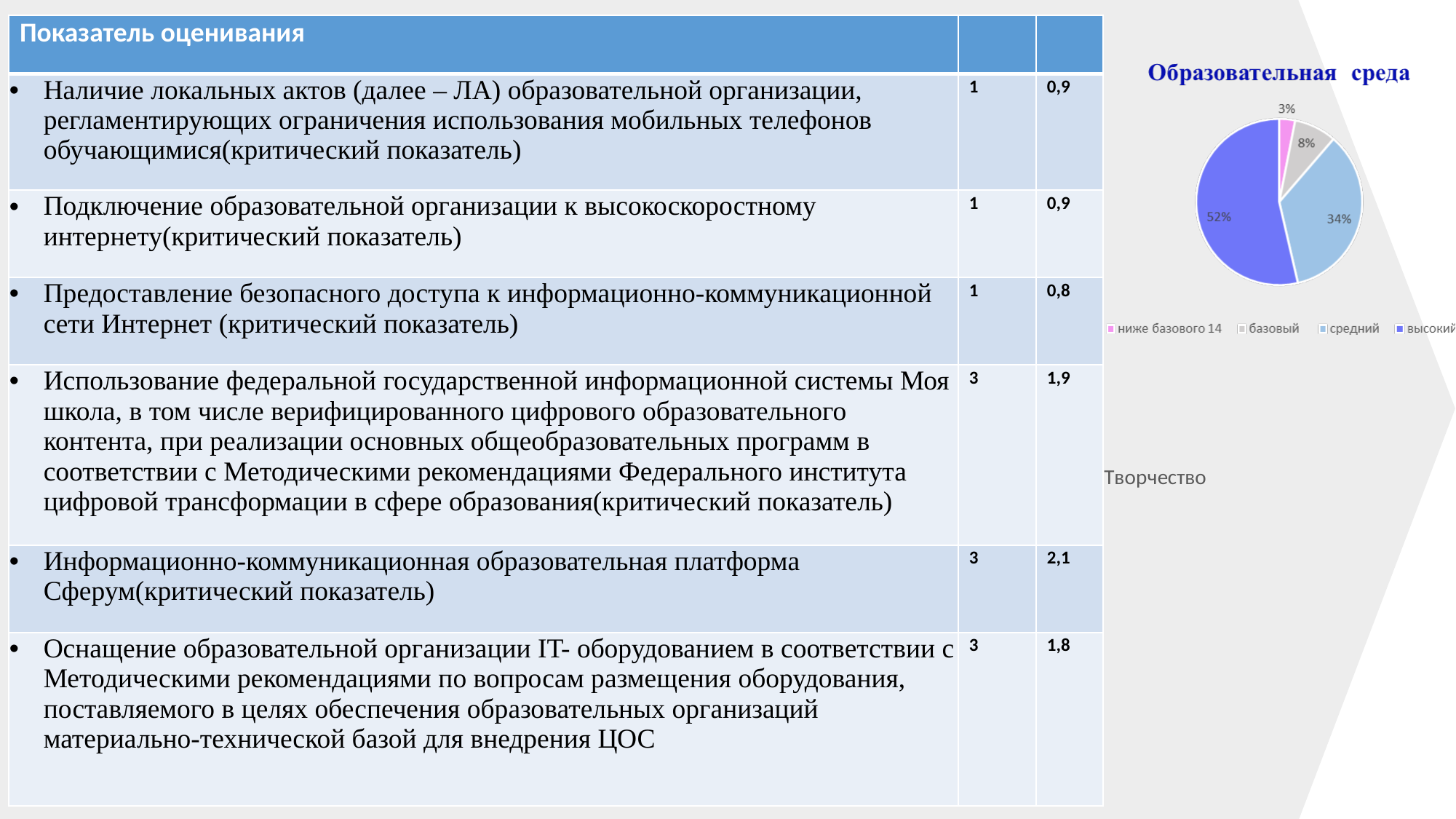
What is the value shown for "базовый" in the pie chart? 8% Which category has the smallest slice in the pie chart? ниже базового 14 What is the title of the pie chart? Образовательная среда Which category has the largest slice in the pie chart? высокий Which is larger in the pie chart: "средний" or "базовый"? средний What share of the pie chart does the "высокий" slice represent? 52% What is the value shown for "ниже базового 14" in the pie chart? 3% What share of the pie chart does the "средний" slice represent? 34% What is the difference in percentage points between the "высокий" and "средний" slices? 18 What kind of chart is shown on the slide? pie chart How many slices does the pie chart have? 4 How many categories does the legend of the pie chart list? 4